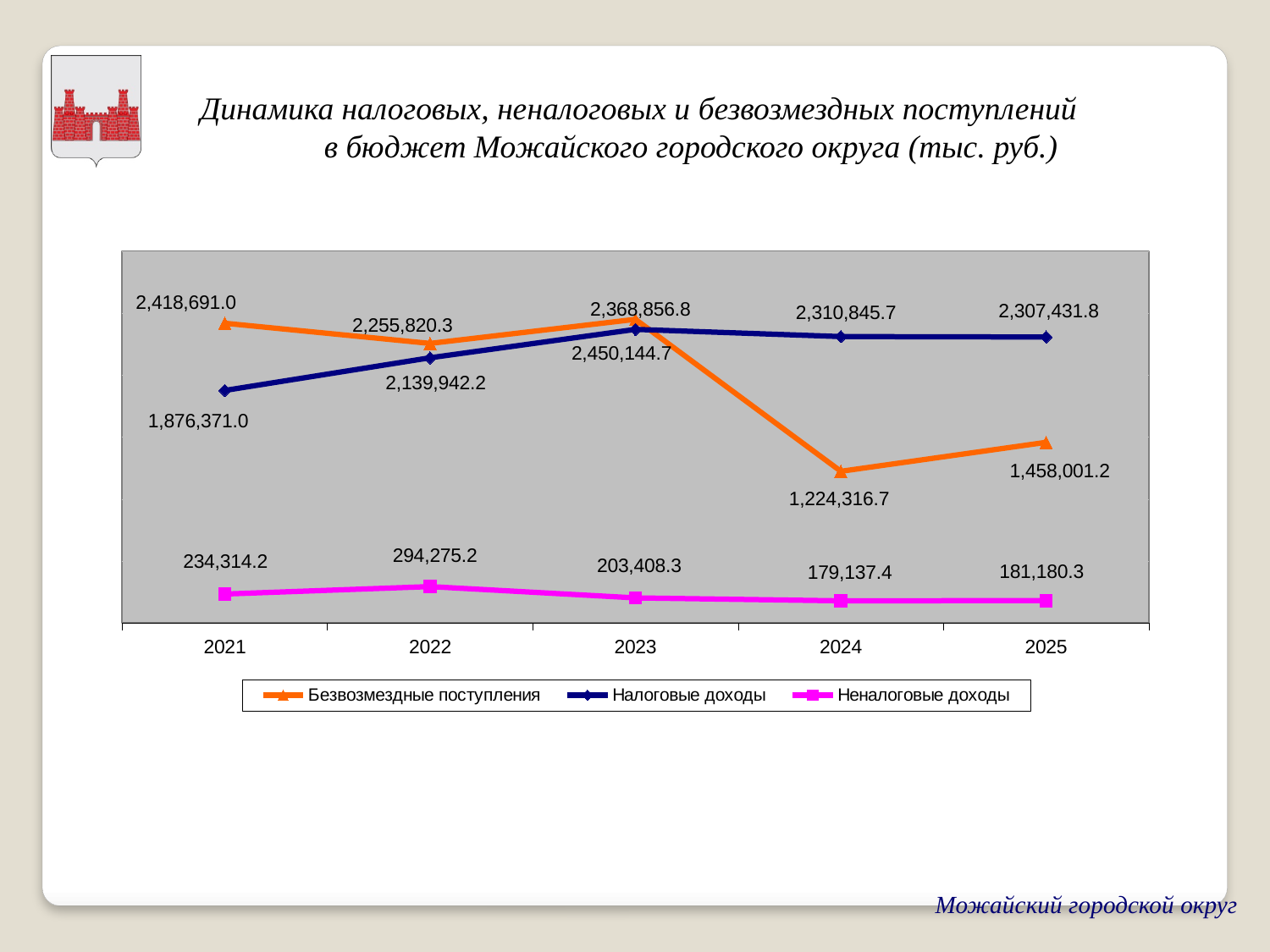
In which year are Безвозмездные поступления lowest? 2024 How many series does the legend list? 3 What is the value of Безвозмездные поступления in 2024? 1,224,316.7 What is the value of Безвозмездные поступления in 2021? 2,418,691.0 What is the difference between Неналоговые доходы in 2022 and in 2021? 59,961.0 What is the value of Налоговые доходы in 2021? 1,876,371.0 How many years are shown on the x axis? 5 In which year are Неналоговые доходы highest? 2022 What kind of chart is shown on the slide? Line chart Which is larger in 2021: Безвозмездные поступления or Налоговые доходы? Безвозмездные поступления What is the value of Налоговые доходы in 2025? 2,307,431.8 What is the value of Неналоговые доходы in 2022? 294,275.2